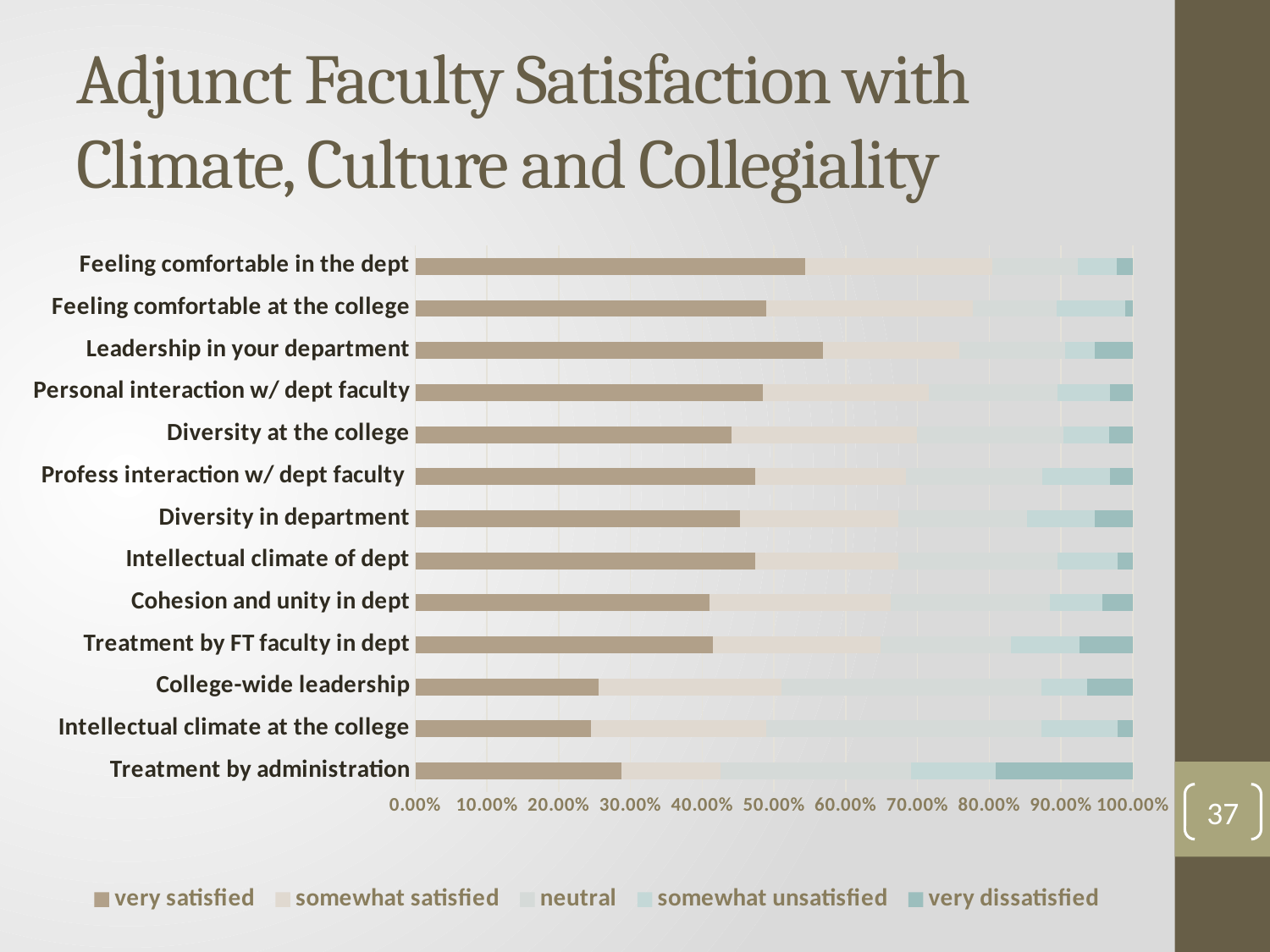
What kind of chart is shown on the slide? Stacked bar chart What is the title of the slide containing the chart? Adjunct Faculty Satisfaction with Climate, Culture and Collegiality How many categories (survey items) are plotted on the chart? 13 Which category has the largest 'very dissatisfied' segment? Treatment by administration Is the 'very satisfied' value for Leadership in your department greater or less than 50.00%? greater Is the 'very satisfied' value for Treatment by administration greater or less than 40.00%? less How many series does the legend list? 5 Is the 'very satisfied' value for College-wide leadership greater or less than 30.00%? less Which category has the largest 'very satisfied' segment? Leadership in your department Which has a larger 'very satisfied' segment: Feeling comfortable in the dept or Diversity at the college? Feeling comfortable in the dept Which legend entry is listed last in the chart's legend? very dissatisfied Which has a larger 'very satisfied' segment: Leadership in your department or Cohesion and unity in dept? Leadership in your department